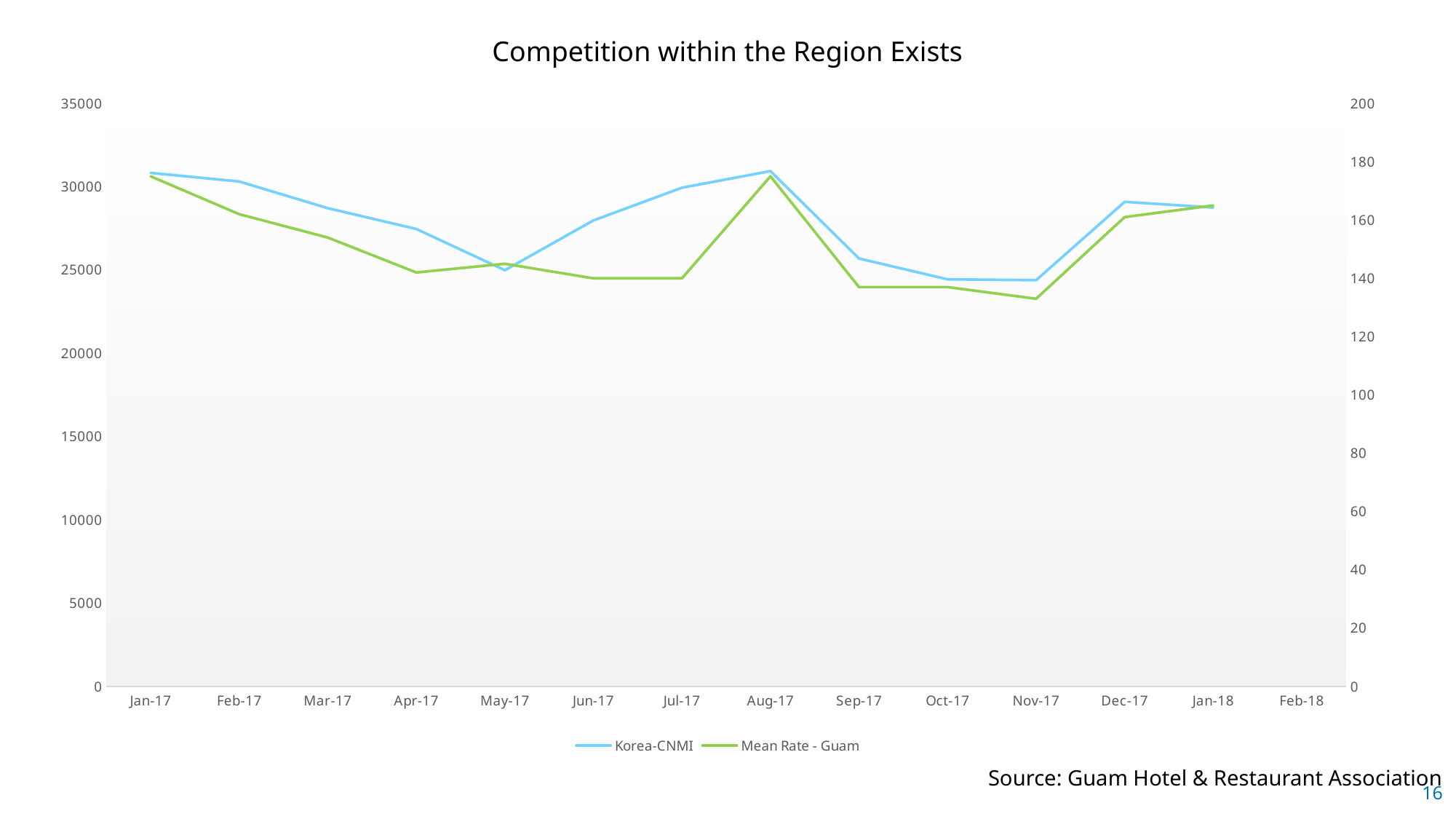
Does the Mean Rate - Guam line rise or fall from Nov-17 to Jan-18? rise Is the value for Mean Rate - Guam in Aug-17 greater or less than 160? greater Is the value for Korea-CNMI in Apr-17 greater or less than 30000? less What kind of chart is shown on the slide? line chart What is the title of the chart? Competition within the Region Exists Which month has the lowest value for Mean Rate - Guam? Nov-17 Does the Korea-CNMI line rise or fall from Jan-17 to May-17? fall How many month labels are shown on the x axis? 14 How many series does the legend list? 2 Is the value for Korea-CNMI in Jan-17 greater or less than 30000? greater Which two series are listed in the legend? Korea-CNMI and Mean Rate - Guam